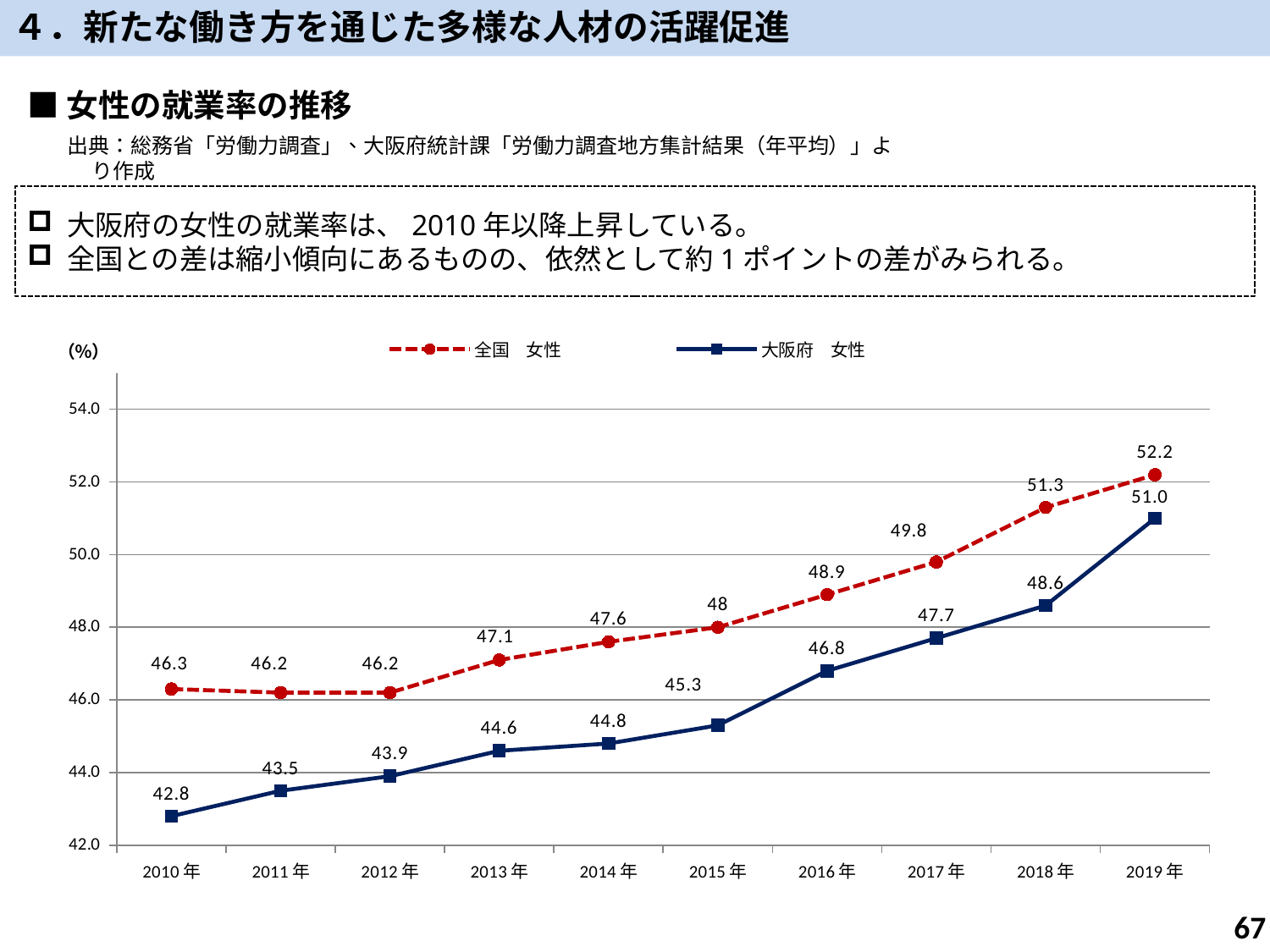
How many series does the legend list? 2 In which year is the value for 大阪府 女性 the lowest? 2010年 What is the value for 全国 女性 in 2014年? 47.6 In which year is the value for 全国 女性 the highest? 2019年 What type of chart is shown on the slide? line chart What is the value for 大阪府 女性 in 2015年? 45.3 What is the difference between 全国 女性 and 大阪府 女性 in 2019年? 1.2 Which is larger in 2016年, 全国 女性 or 大阪府 女性? 全国 女性 Does the value for 大阪府 女性 rise or fall from 2010年 to 2019年? rise What is the value for 全国 女性 in 2019年? 52.2 How many years are plotted on the x axis? 10 What is the value for 大阪府 女性 in 2010年? 42.8